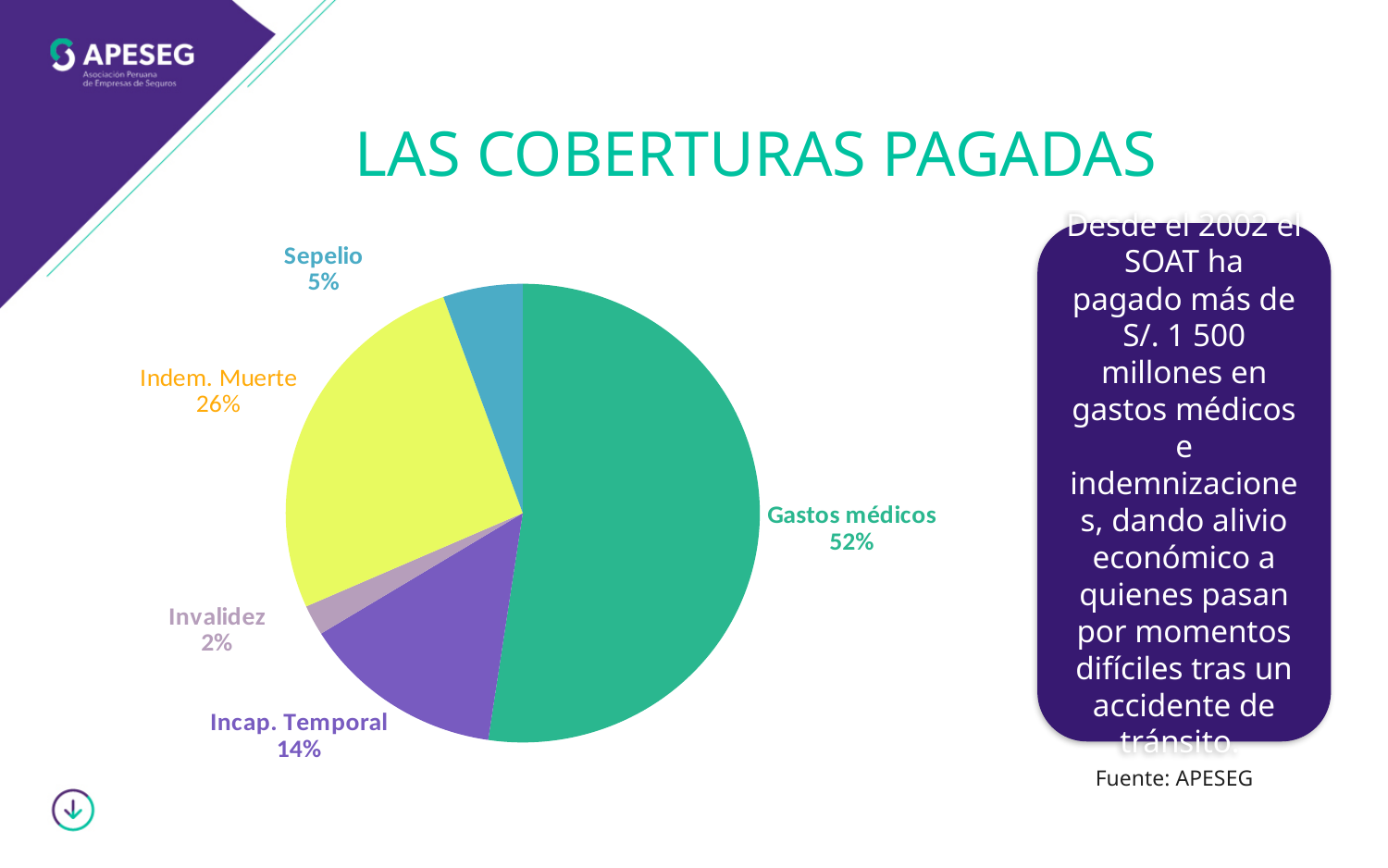
What is the value shown for Indem. Muerte? 26% What is the title of the slide containing the chart? LAS COBERTURAS PAGADAS Which category has the largest slice of the pie? Gastos médicos What is the difference between the shares of Gastos médicos and Indem. Muerte? 26% What kind of chart is shown on the slide? Pie chart What is the value shown for Incap. Temporal? 14% How many categories are shown in the pie chart? 5 Which category has the smallest slice of the pie? Invalidez What is the value shown for Sepelio? 5% What share of the pie does Gastos médicos represent? 52% Which is larger, the share for Incap. Temporal or the share for Sepelio? Incap. Temporal What is the value shown for Invalidez? 2%